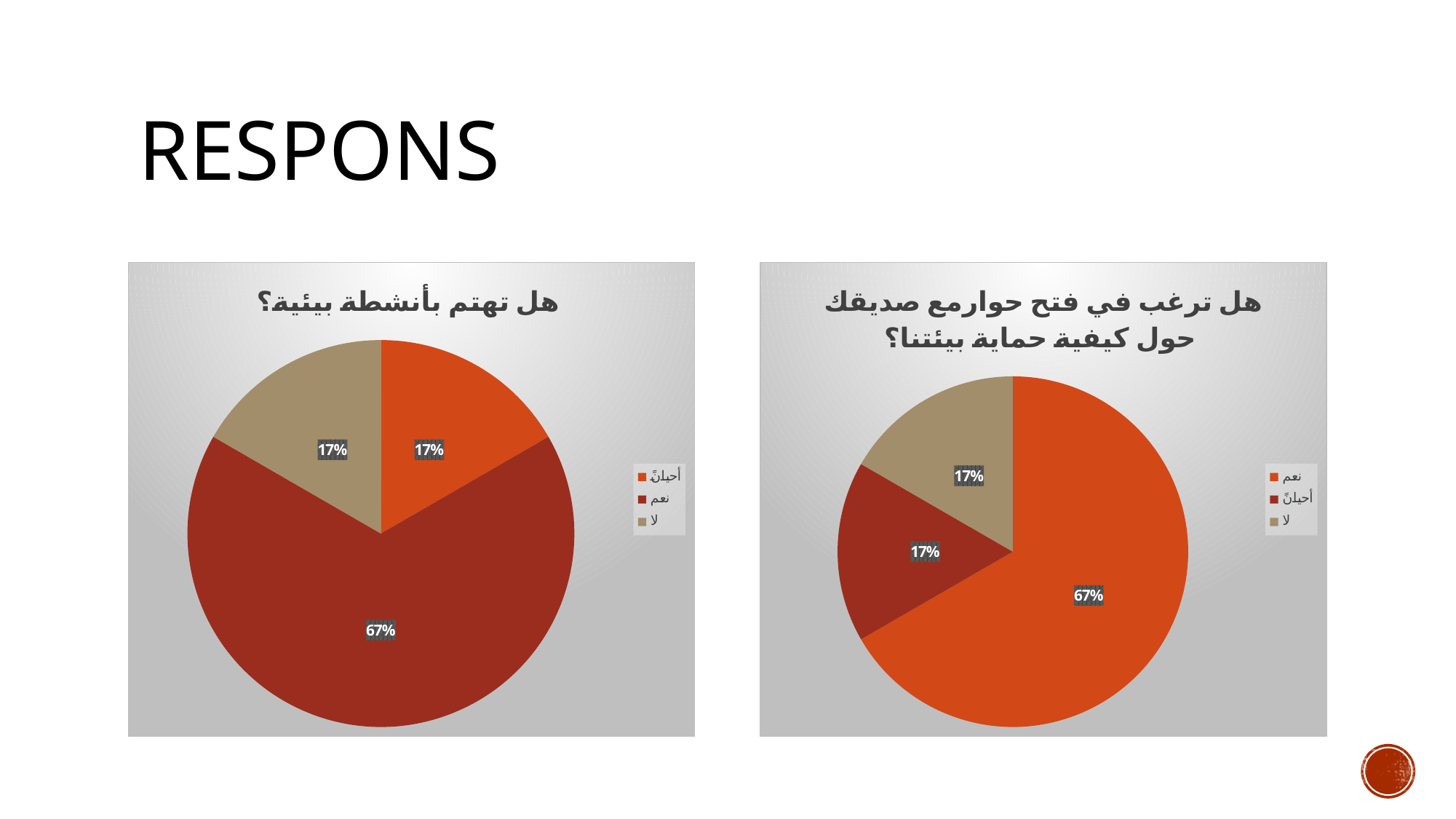
In the right chart ("هل ترغب في فتح حوار مع صديقك حول كيفية حماية بيئتنا؟"), what share of the pie is "نعم"? 67% What kind of chart is the left chart titled "هل تهتم بأنشطة بيئية؟"? Pie chart In the left chart ("هل تهتم بأنشطة بيئية؟"), what share of the pie is "نعم"? 67% How many slices does the right chart ("هل ترغب في فتح حوار مع صديقك حول كيفية حماية بيئتنا؟") have? 3 How many categories does the legend of the left chart ("هل تهتم بأنشطة بيئية؟") list? 3 In the left chart ("هل تهتم بأنشطة بيئية؟"), what share of the pie is "لا"? 17% In the right chart ("هل ترغب في فتح حوار مع صديقك حول كيفية حماية بيئتنا؟"), what colour is the "نعم" slice? Orange In the right chart ("هل ترغب في فتح حوار مع صديقك حول كيفية حماية بيئتنا؟"), which is larger, the "نعم" slice or the "لا" slice? نعم In the left chart ("هل تهتم بأنشطة بيئية؟"), what is the difference between the "نعم" share and the "أحياناً" share? 50% In the left chart ("هل تهتم بأنشطة بيئية؟"), which category has the largest slice? نعم In the right chart ("هل ترغب في فتح حوار مع صديقك حول كيفية حماية بيئتنا؟"), which category has the largest slice? نعم